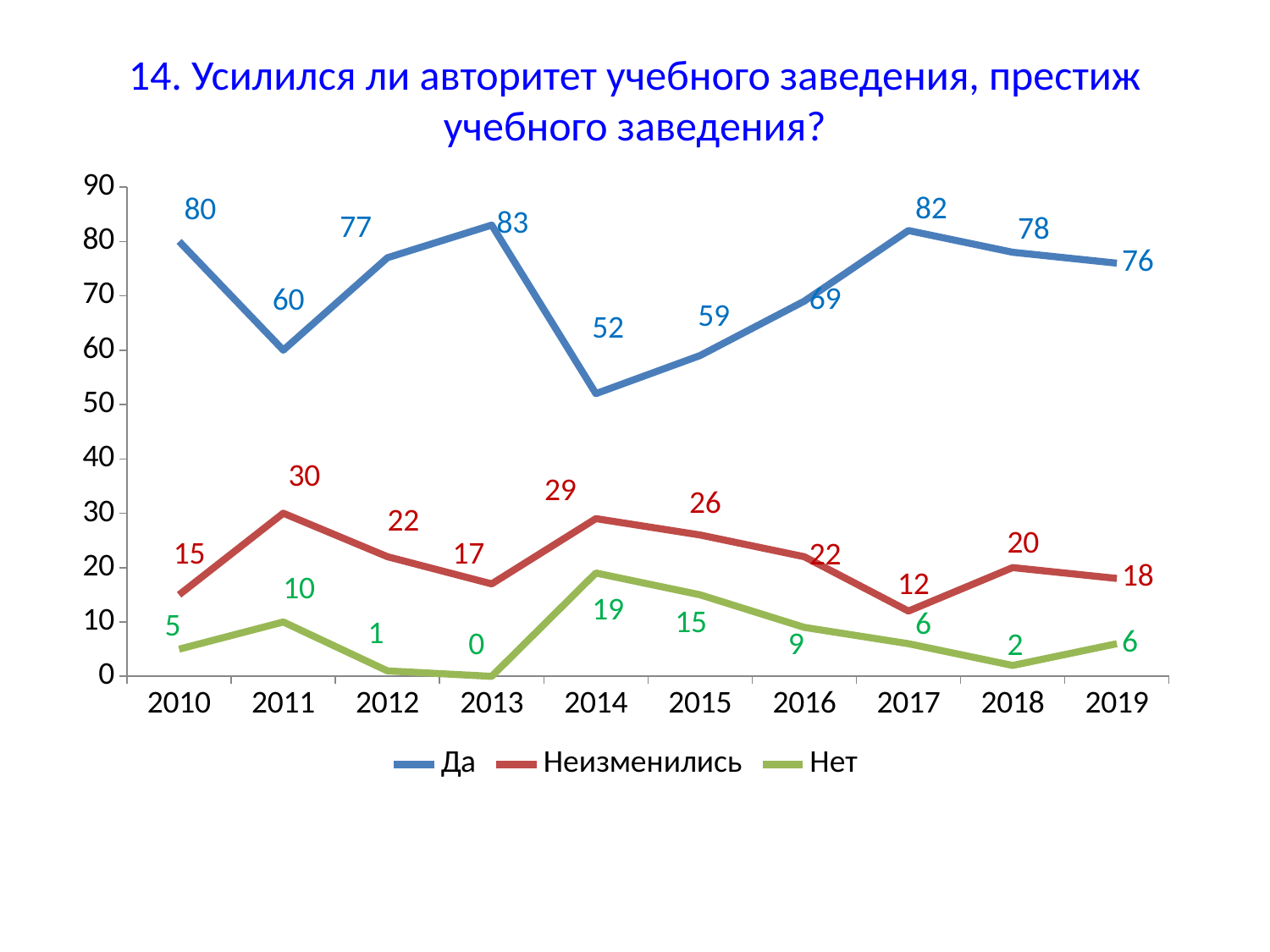
In which year is the value for Нет the lowest? 2013 In which year is the value for Да the lowest? 2014 How many years are shown on the x axis? 10 What is the value for Неизменились in 2011? 30 How many series does the legend list? 3 Which is larger: the Неизменились value in 2015 or in 2018? 2015 Which series is drawn in green? Нет What is the difference between the Да values in 2017 and 2014? 30 What is the value for Нет in 2014? 19 What kind of chart is shown on the slide? line chart In which year is the value for Неизменились the highest? 2011 What is the value for Да in 2013? 83